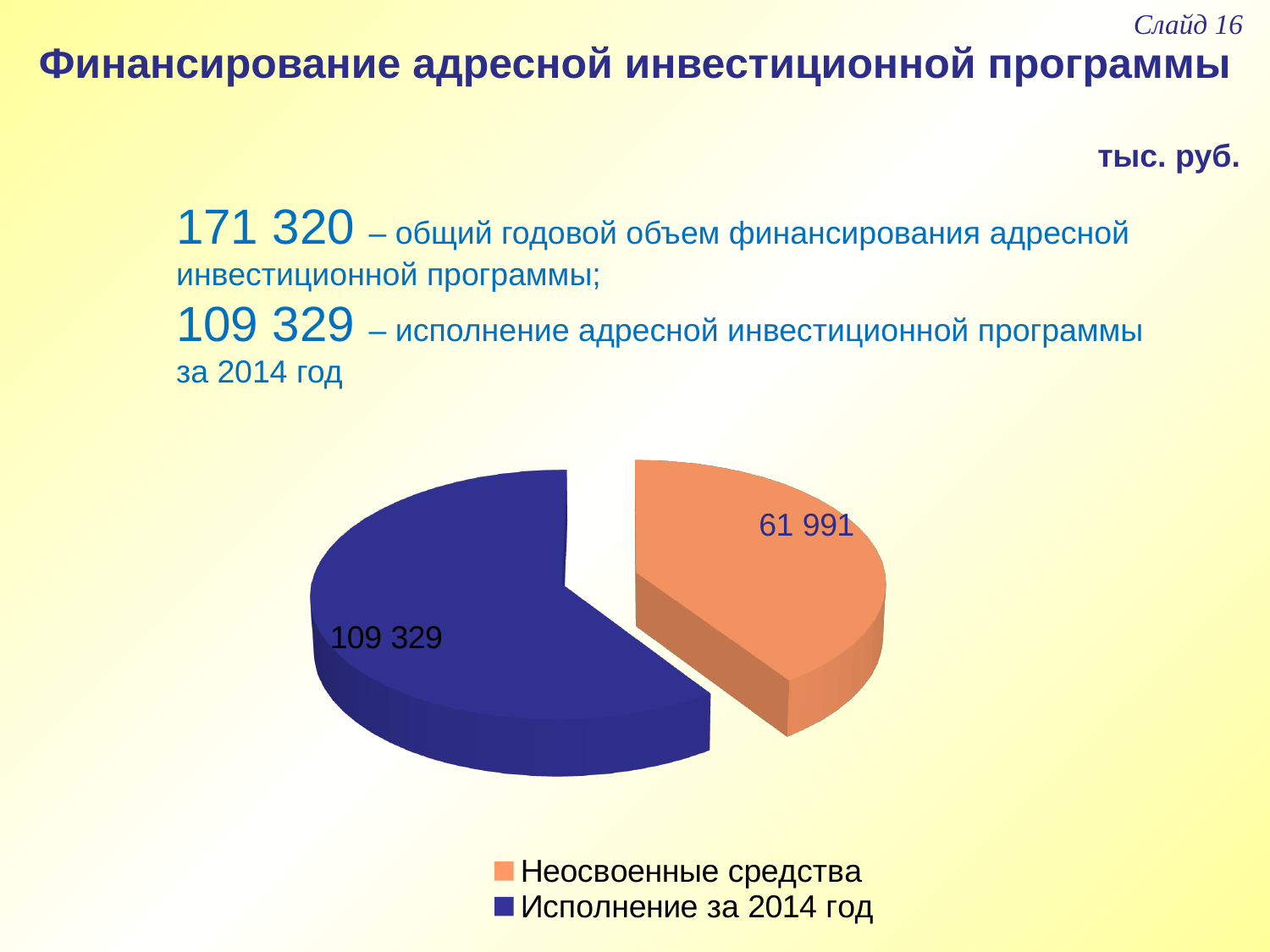
Which slice of the pie chart is the smallest? Неосвоенные средства What colour is the "Исполнение за 2014 год" slice in the pie chart? Blue How many slices does the pie chart have? 2 What colour is the "Неосвоенные средства" slice in the pie chart? Orange What value is shown for the "Неосвоенные средства" slice of the pie chart? 61 991 How many entries does the chart legend list? 2 Which slice of the pie chart is the largest? Исполнение за 2014 год What is the total of the two slices in the pie chart? 171 320 What value is shown for the "Исполнение за 2014 год" slice of the pie chart? 109 329 What is the difference between the "Исполнение за 2014 год" slice and the "Неосвоенные средства" slice? 47 338 What type of chart is shown on the slide? Pie chart Which is larger: "Неосвоенные средства" or "Исполнение за 2014 год"? Исполнение за 2014 год